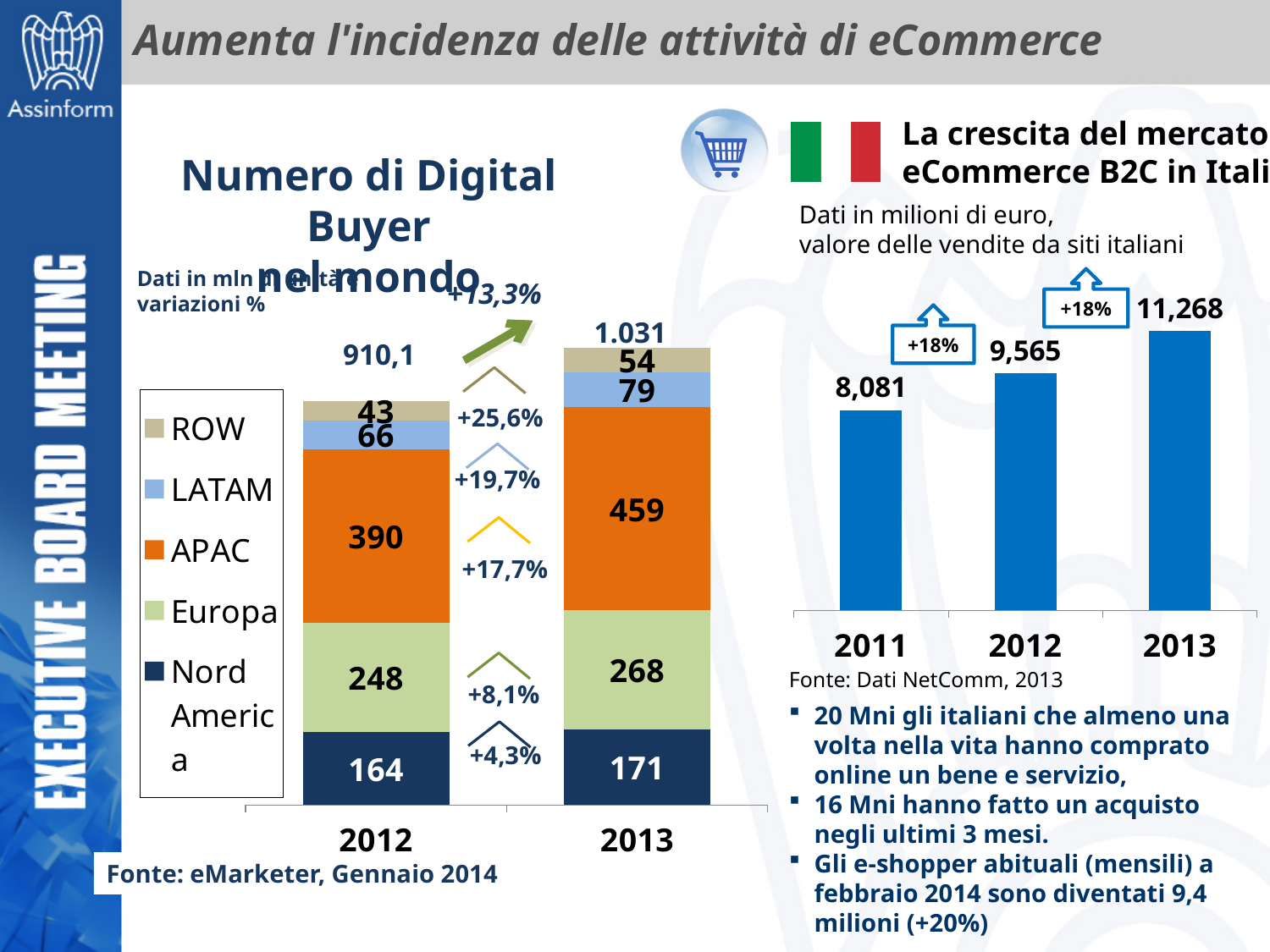
In the chart 'Numero di Digital Buyer nel mondo', what is the total shown for the 2013 bar? 1.031 In the chart 'Numero di Digital Buyer nel mondo', what is the difference between the Europa values for 2013 and 2012? 20 In the chart 'Numero di Digital Buyer nel mondo', what percentage change is shown for LATAM between 2012 and 2013? +19,7% In the chart 'Numero di Digital Buyer nel mondo', which region has the largest segment in the 2012 bar? APAC In the chart 'Numero di Digital Buyer nel mondo', what is the value for APAC in 2013? 459 In the chart 'Numero di Digital Buyer nel mondo', how many series does the legend list? 5 What kind of chart is 'La crescita del mercato eCommerce B2C in Italia'? bar chart In the chart 'La crescita del mercato eCommerce B2C in Italia', which year has the lowest value? 2011 In the chart 'La crescita del mercato eCommerce B2C in Italia', do the values rise or fall from 2011 to 2013? rise In the chart 'Numero di Digital Buyer nel mondo', what is the value for Nord America in 2012? 164 In the chart 'La crescita del mercato eCommerce B2C in Italia', what is the value for 2013? 11,268 In the chart 'Numero di Digital Buyer nel mondo', which region has the smallest segment in the 2013 bar? ROW